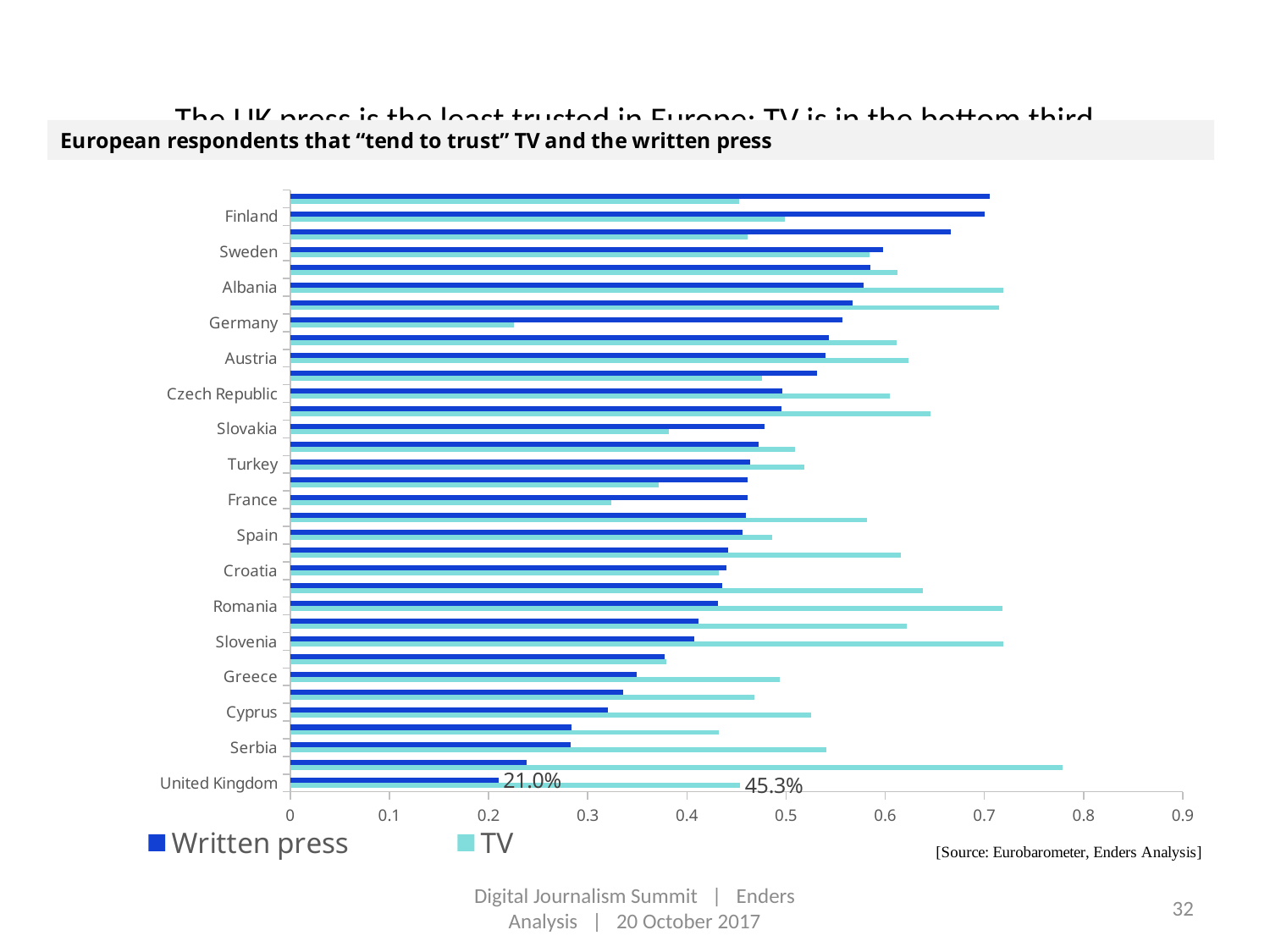
Is the TV value for Germany greater or less than 0.3? less Is the written press value for Finland greater or less than 0.6? greater Which labelled country has the lowest written press value? United Kingdom What is the TV value for the United Kingdom? 45.3% For the United Kingdom, which is larger: the TV value or the written press value? TV Do the written press values rise or fall going from the top of the chart to the bottom? fall Is the TV value for France greater or less than 0.4? less What are the two legend entries of the chart? Written press and TV How many series does the legend list? 2 What is the written press value for the United Kingdom? 21.0% What kind of chart is shown on the slide? bar chart